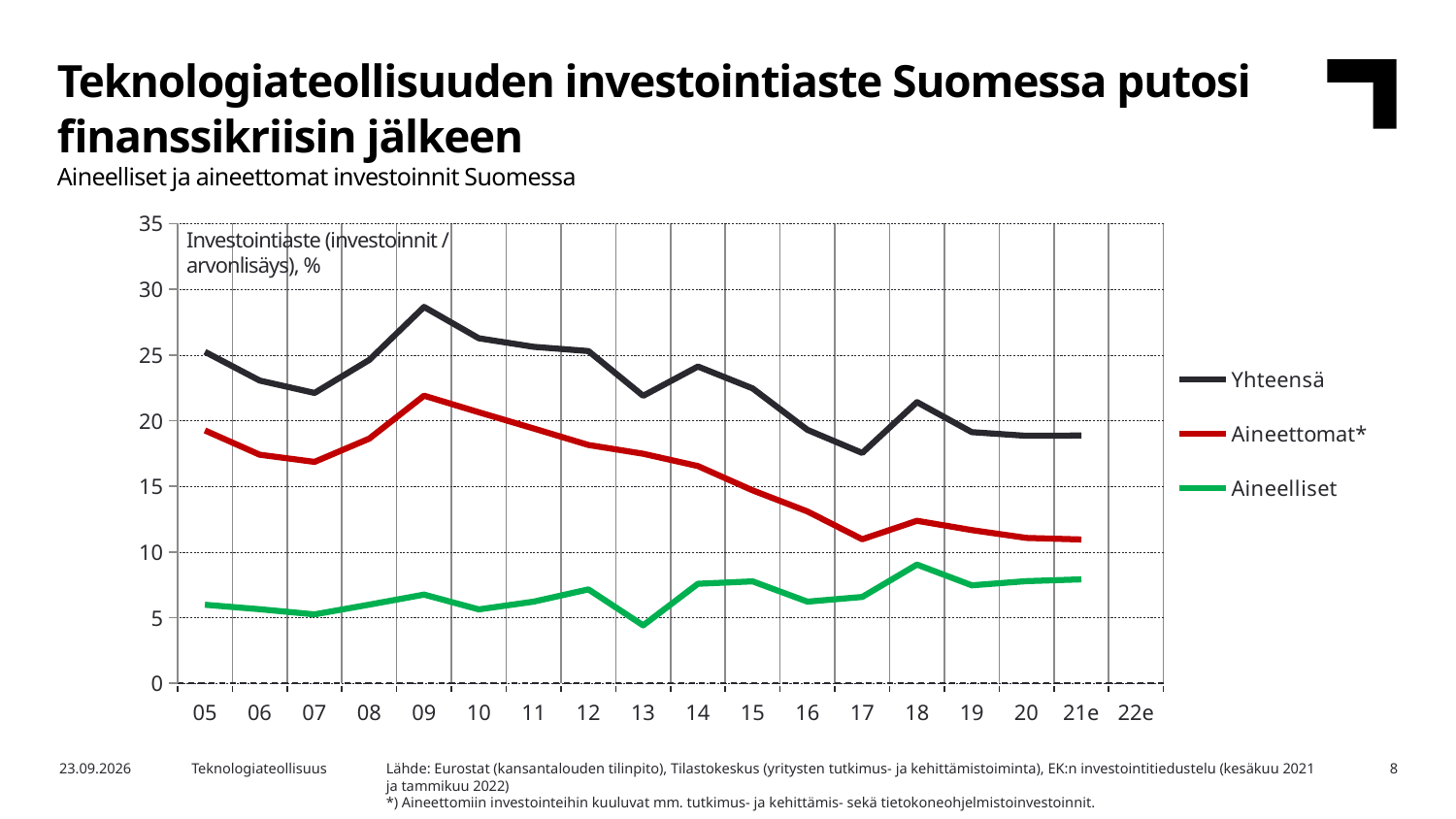
How many series does the legend list? 3 Which is larger in 21e, Aineettomat* or Aineelliset? Aineettomat* In which year does the Yhteensä series reach its highest value? 09 Is the value for Yhteensä in 09 greater or less than 25? greater Is the value for Aineettomat* in 17 greater or less than 15? less What label is printed inside the plot area describing the measure? Investointiaste (investoinnit / arvonlisäys), % Does the Aineettomat* series rise or fall from 09 to 17? fall What kind of chart is shown on the slide? line chart In which year does the Aineelliset series reach its lowest value? 13 Which series is drawn in green? Aineelliset In which year does the Aineettomat* series reach its highest value? 09 Is the value for Yhteensä in 17 greater or less than 20? less